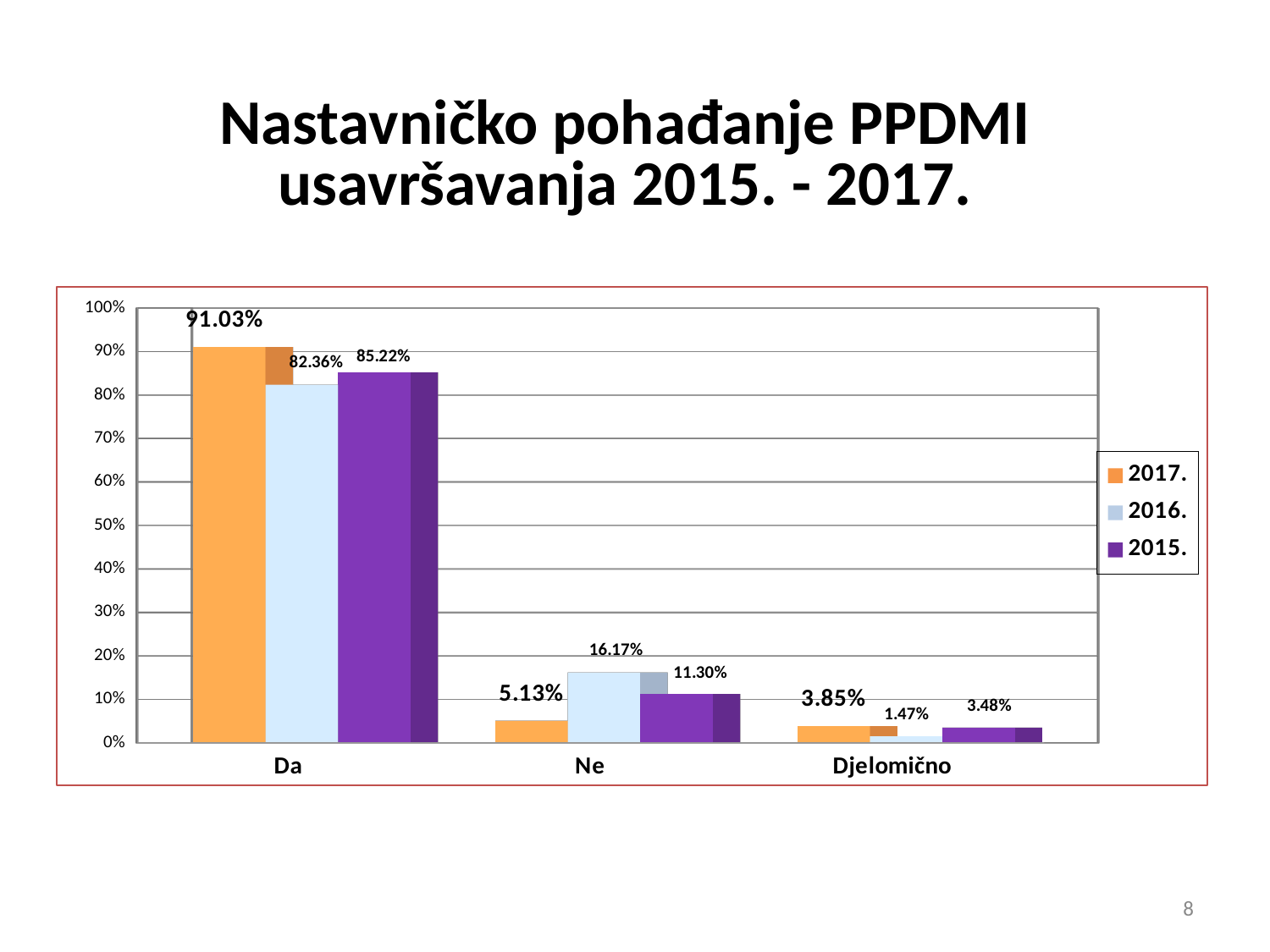
How many categories are shown on the x axis? 3 What is the value for 'Da' in the 2017. series? 91.03% Which is larger for 'Ne': the 2016. value or the 2015. value? 2016. What is the value for 'Djelomično' in the 2015. series? 3.48% Which series has the lowest value for 'Djelomično'? 2016. What kind of chart is shown on the slide? bar chart Is the value for 'Da' in the 2016. series greater or less than 80%? greater What is the value for 'Da' in the 2015. series? 85.22% What is the difference between the 2017. and 2016. values for 'Da'? 8.67% What is the value for 'Ne' in the 2016. series? 16.17% How many series does the legend list? 3 Which series has the highest value for 'Da'? 2017.